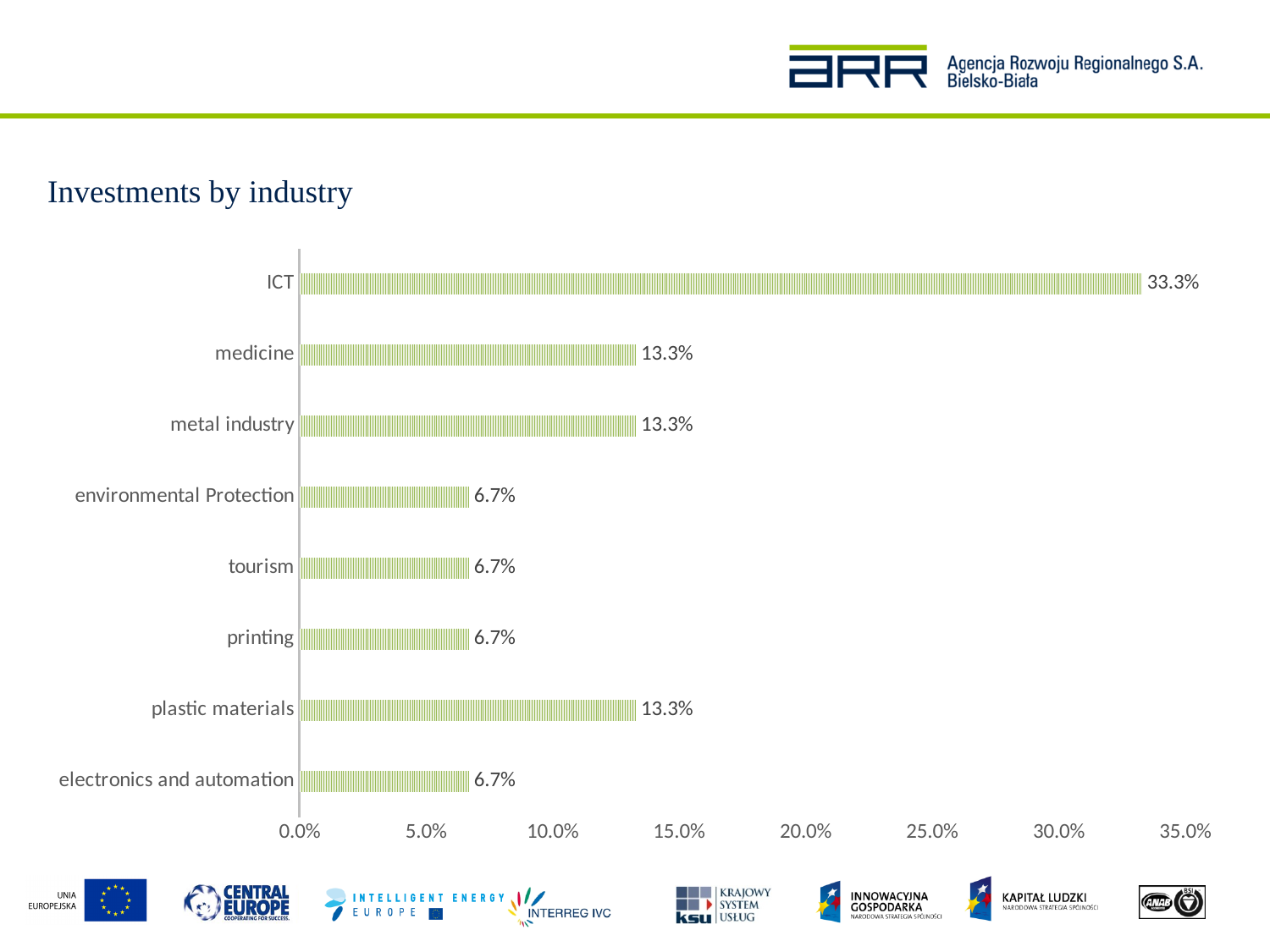
Which industry has the highest share of investments? ICT What is the title of the chart? Investments by industry What is the value for plastic materials? 13.3% What kind of chart is shown on the slide? bar chart Which is larger, the value for plastic materials or the value for electronics and automation? plastic materials Is the value for ICT greater or less than 30.0%? greater How many industries are shown in the chart? 8 What is the difference between the values for medicine and printing? 6.6% What is the value for ICT? 33.3% What is the value for tourism? 6.7% What is the difference between the values for ICT and metal industry? 20.0% What is the value for medicine? 13.3%